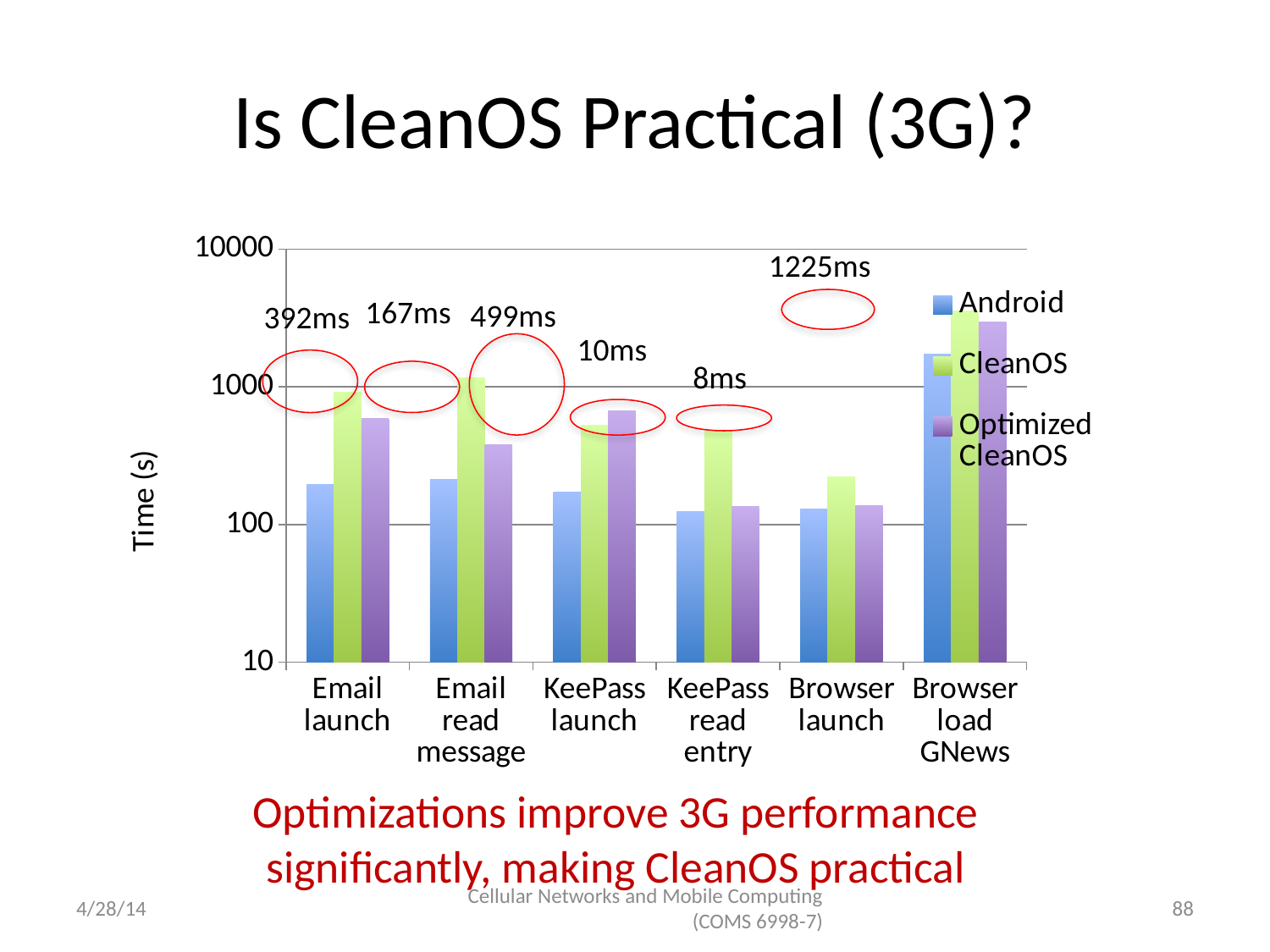
Is the CleanOS value for Email read message greater or less than 1000? greater Is the Android value for Browser load GNews greater or less than 1000? greater For KeePass launch, which is larger: the CleanOS value or the Optimized CleanOS value? Optimized CleanOS How many series does the chart's legend list? 3 For which category is the CleanOS bar the lowest? Browser launch What is the label of the chart's y axis? Time (s) For which category is the Android bar the highest? Browser load GNews Is the Android value for Email launch greater or less than 1000? less What kind of chart is shown on the slide? bar chart Which series are listed in the chart's legend? Android, CleanOS, Optimized CleanOS How many categories are shown on the x axis of the chart? 6 For Email launch, which is larger: the CleanOS value or the Optimized CleanOS value? CleanOS